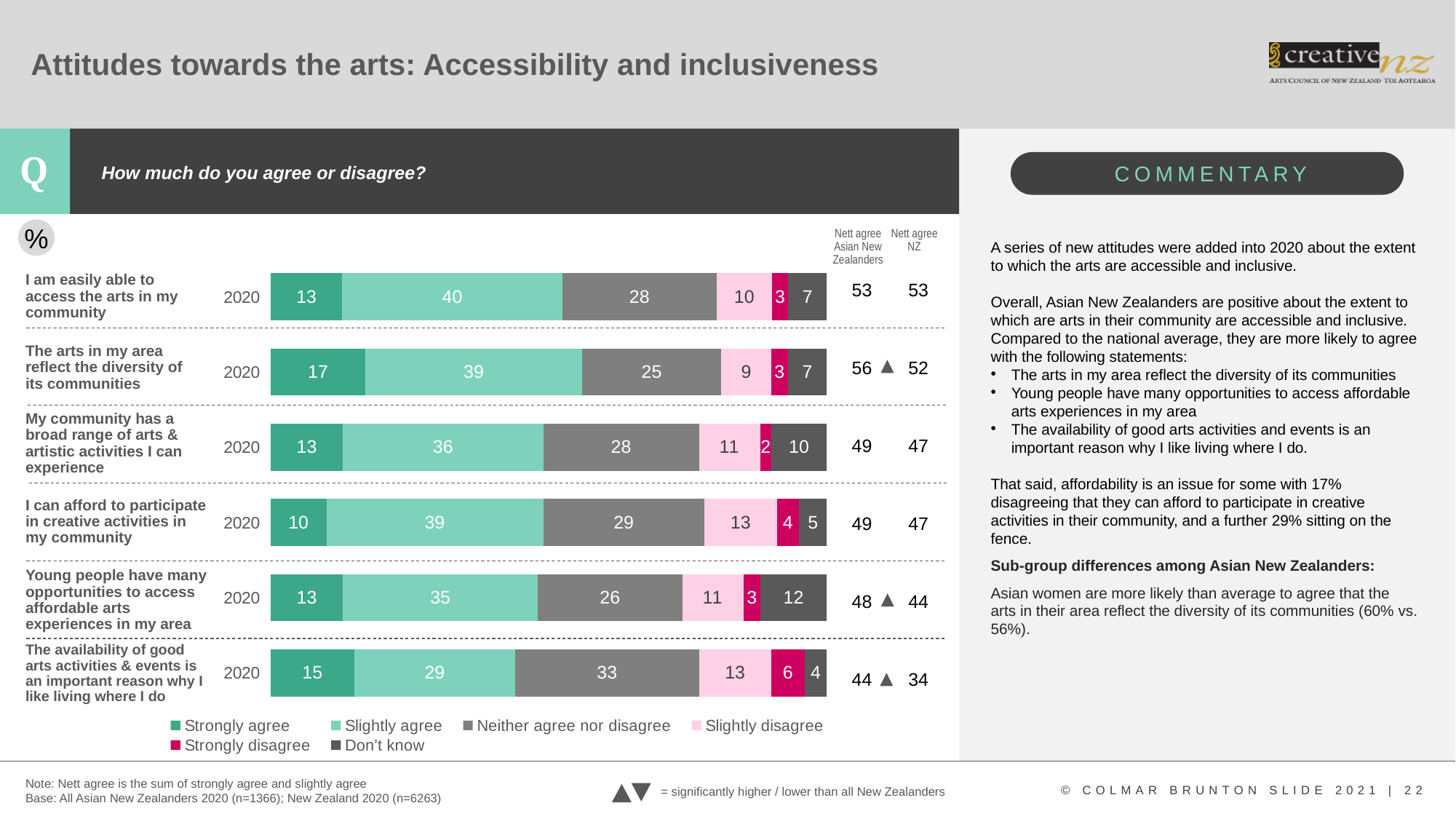
Which statement has the highest Strongly agree value? The arts in my area reflect the diversity of its communities How many statements are shown in the chart? 6 What is the difference between the Slightly agree values for "I am easily able to access the arts in my community" and "The availability of good arts activities & events is an important reason why I like living where I do"? 11 Which has the larger Don't know value: "Young people have many opportunities to access affordable arts experiences in my area" or "I am easily able to access the arts in my community"? Young people have many opportunities to access affordable arts experiences in my area What is the Strongly disagree value for "The availability of good arts activities & events is an important reason why I like living where I do"? 6 Which statement has the lowest Strongly agree value? I can afford to participate in creative activities in my community Which statement has the highest Don't know value? Young people have many opportunities to access affordable arts experiences in my area What is the Nett agree value for Asian New Zealanders for "The availability of good arts activities & events is an important reason why I like living where I do"? 44 What is the Strongly agree value for "I am easily able to access the arts in my community"? 13 How many series does the legend list? 6 What is the Neither agree nor disagree value for "The availability of good arts activities & events is an important reason why I like living where I do"? 33 What kind of chart is shown on the slide? Stacked bar chart